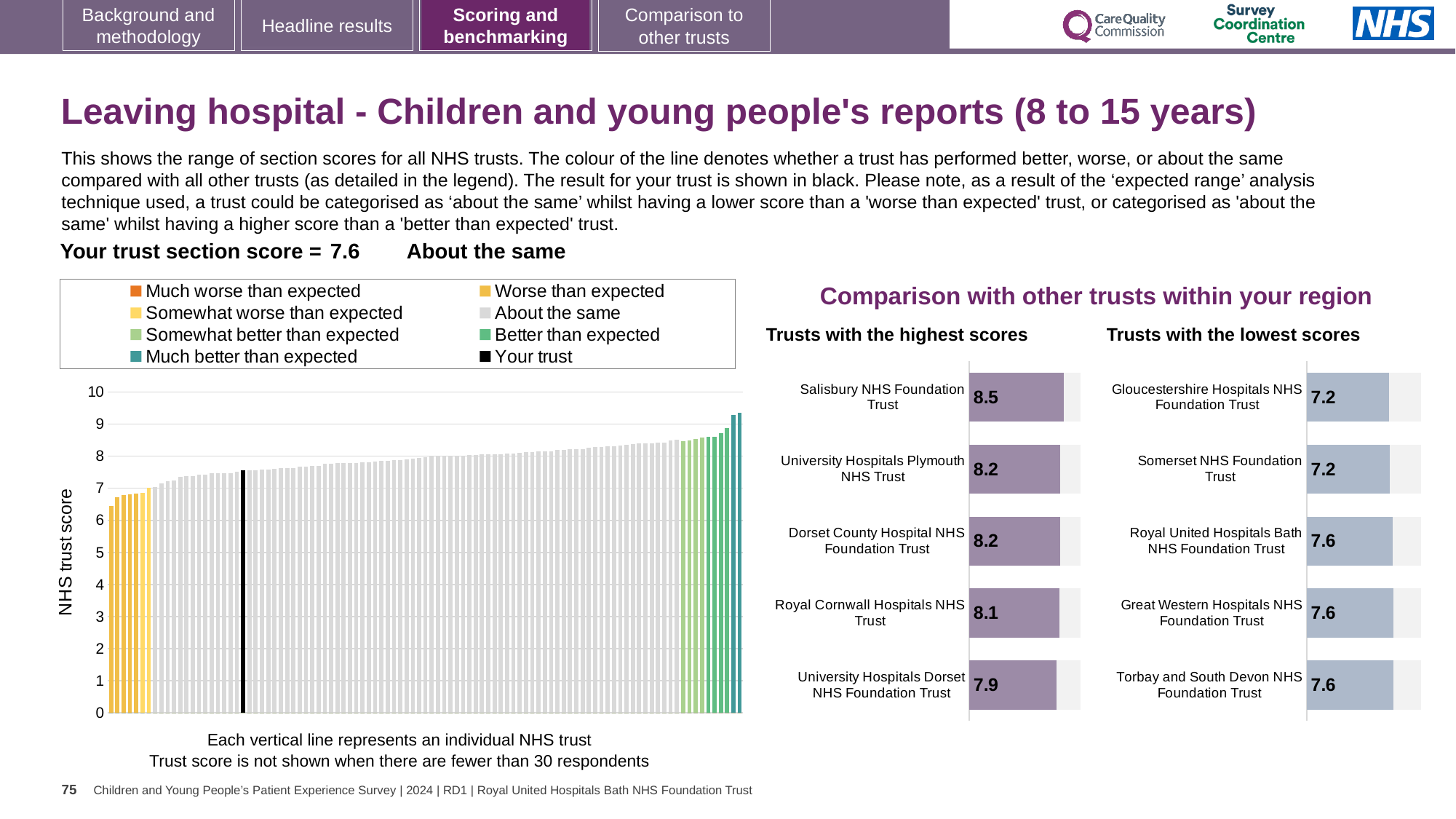
How many trusts are shown in the 'Trusts with the highest scores' chart? 5 In the large chart on the left, do the trust scores rise or fall from left to right? Rise How many trusts are shown in the 'Trusts with the lowest scores' chart? 5 In the 'Trusts with the lowest scores' chart, what is the score for Torbay and South Devon NHS Foundation Trust? 7.6 In the large chart on the left, what is the section score for your trust (the black bar)? 7.6 How many entries does the legend of the large chart on the left list? 8 What kind of chart is the large chart on the left showing the range of section scores for all NHS trusts? Bar chart In the 'Trusts with the highest scores' chart, what is the score for Salisbury NHS Foundation Trust? 8.5 In the 'Trusts with the highest scores' chart, what is the difference between the scores of Salisbury NHS Foundation Trust and University Hospitals Dorset NHS Foundation Trust? 0.6 In the 'Trusts with the highest scores' chart, which trust has the highest score? Salisbury NHS Foundation Trust In the 'Trusts with the highest scores' chart, which has the larger score: Royal Cornwall Hospitals NHS Trust or University Hospitals Dorset NHS Foundation Trust? Royal Cornwall Hospitals NHS Trust In the 'Trusts with the lowest scores' chart, what is the score for Gloucestershire Hospitals NHS Foundation Trust? 7.2